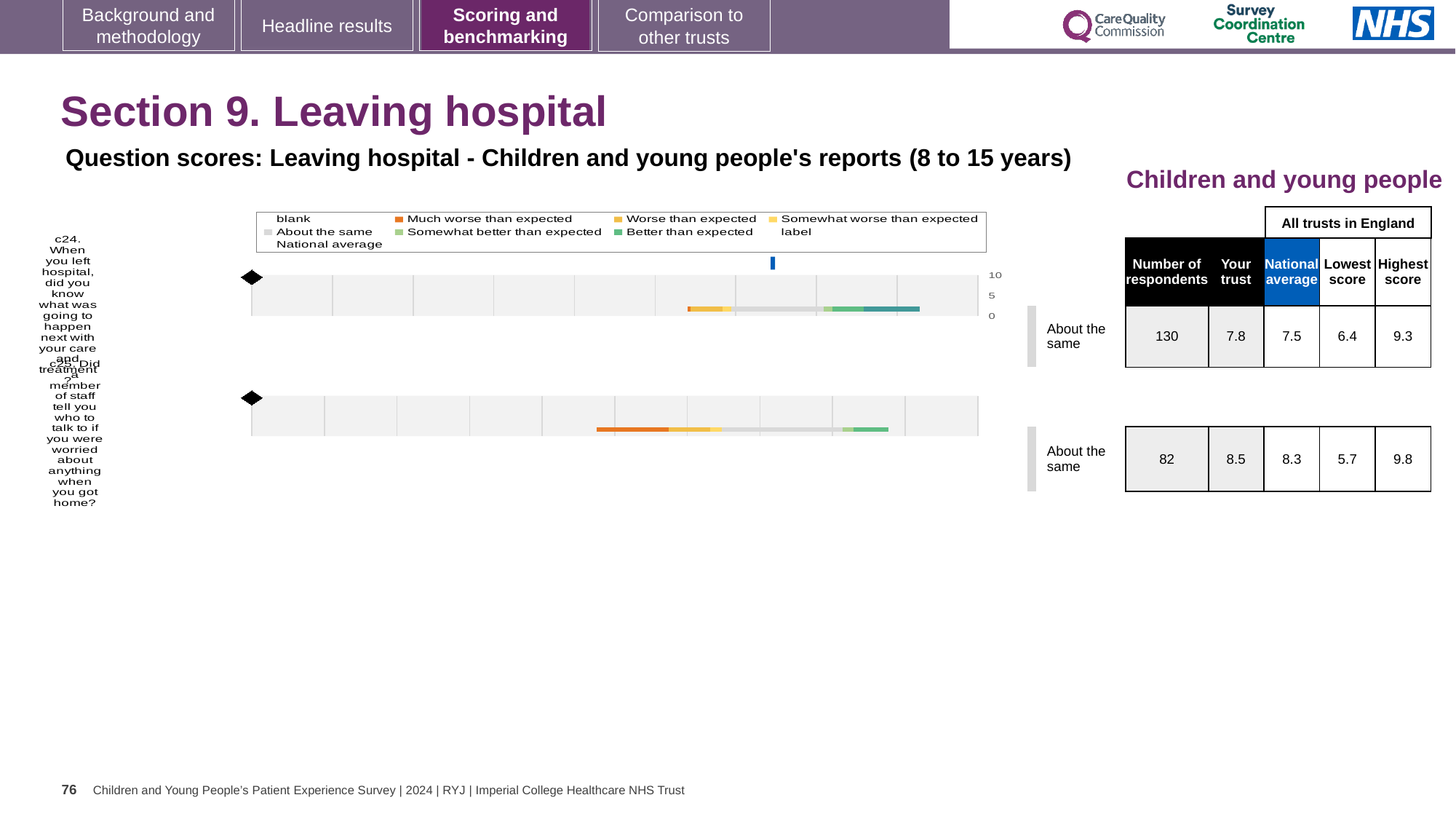
In the table beside the chart, what is the number of respondents for question c25? 82 In the table beside the chart, what is the difference between the highest score and the lowest score for question c24? 2.9 In the table beside the chart, which question has the higher 'Your trust' score, c24 or c25? c25 In the table beside the chart, what is the 'Your trust' score for question c25? 8.5 What benchmark category is given for both questions next to the chart? About the same In the table beside the chart, what is the national average for question c24? 7.5 In the table beside the chart, what is the difference between the 'Your trust' score and the national average for question c25? 0.2 What kind of chart is shown on the slide? bar chart Which legend entry is shown in orange? Much worse than expected How many questions (categories) are plotted in the chart? 2 What is the highest value shown on the chart's axis? 10 In the table beside the chart, what is the 'Your trust' score for question c24? 7.8